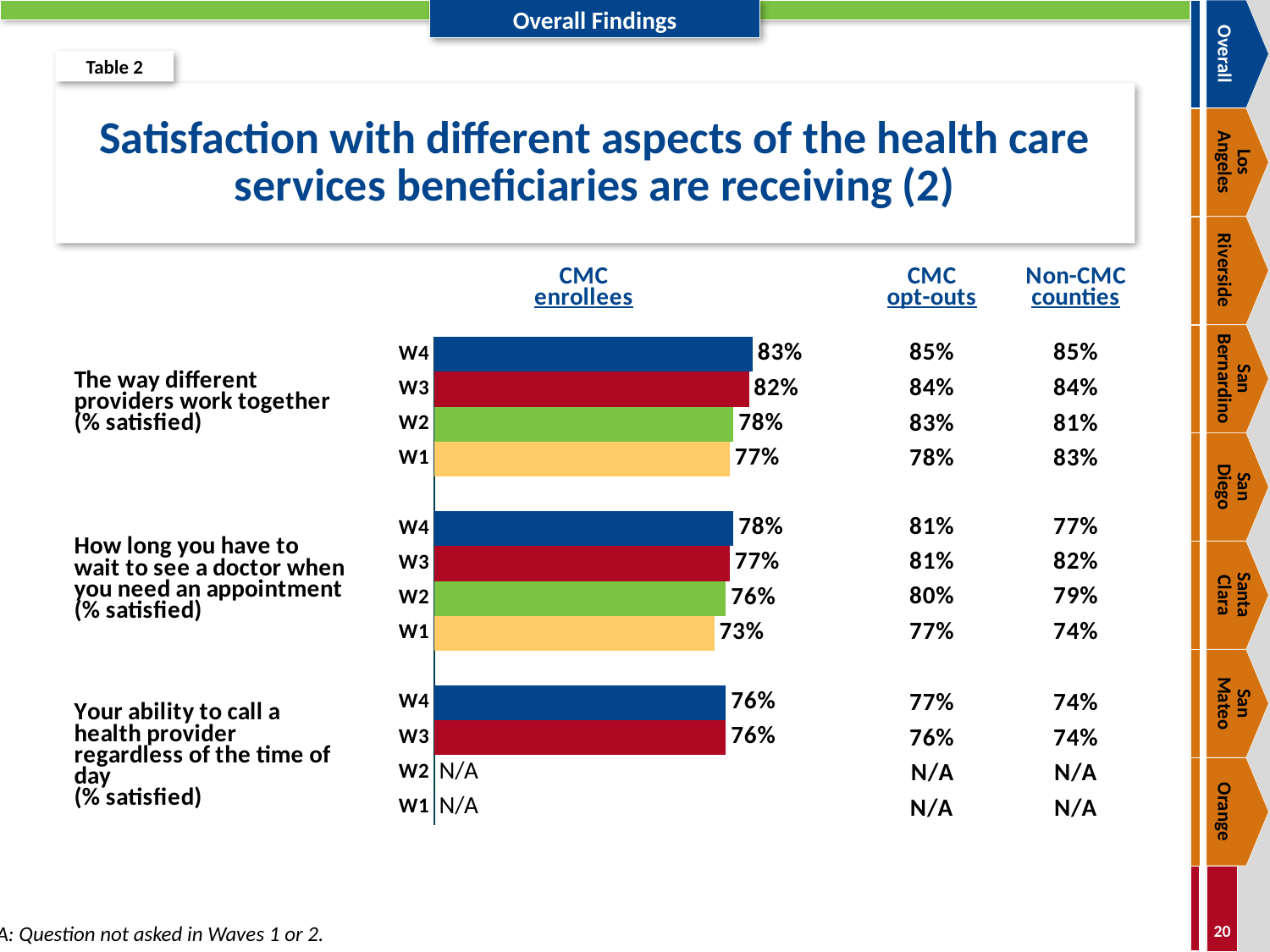
How many waves are shown as N/A for CMC enrollees on 'Your ability to call a health provider regardless of the time of day'? 2 Which wave has the highest CMC enrollees' value for 'The way different providers work together'? W4 What is the difference between the W4 and W1 CMC enrollees' values for 'How long you have to wait to see a doctor when you need an appointment'? 5% What type of chart is used to show the CMC enrollees' satisfaction values? bar chart What colour are the W4 bars for CMC enrollees? dark blue What is the CMC enrollees' W4 value for 'The way different providers work together'? 83% What is the difference between the W4 and W1 CMC enrollees' values for 'The way different providers work together'? 6% For CMC enrollees, which is larger: the W2 value for 'The way different providers work together' or the W2 value for 'How long you have to wait to see a doctor'? The way different providers work together What is the CMC enrollees' W3 value for 'Your ability to call a health provider regardless of the time of day'? 76% Which wave has the lowest CMC enrollees' value for 'How long you have to wait to see a doctor when you need an appointment'? W1 What is the CMC enrollees' W1 value for 'How long you have to wait to see a doctor when you need an appointment'? 73% Do the CMC enrollees' values for 'How long you have to wait to see a doctor when you need an appointment' rise or fall from W1 to W4? rise